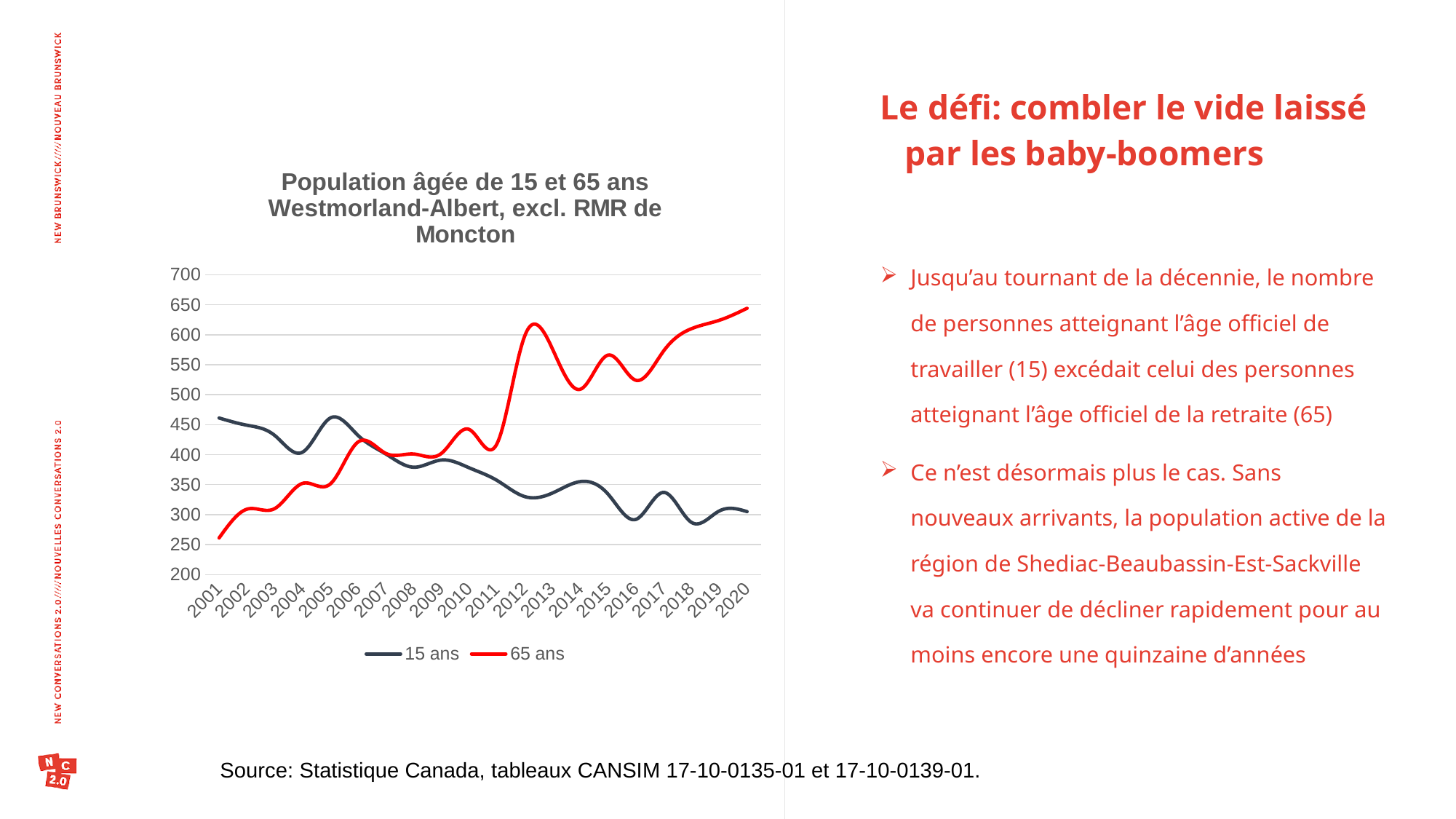
Is the value for 65 ans in 2020 greater or less than 600? greater Does the 65 ans line overall rise or fall from 2001 to 2020? rise What kind of chart is shown on the slide? line chart In 2020, which series has the higher value, 15 ans or 65 ans? 65 ans Which series is drawn in red? 65 ans How many years are plotted along the x axis? 20 How many series does the legend list? 2 In 2001, which series has the higher value, 15 ans or 65 ans? 15 ans Does the 15 ans line overall rise or fall from 2001 to 2020? fall Is the value for 65 ans in 2001 greater or less than 300? less What is the title of the chart? Population âgée de 15 et 65 ans Westmorland-Albert, excl. RMR de Moncton Is the value for 15 ans in 2018 greater or less than 300? less